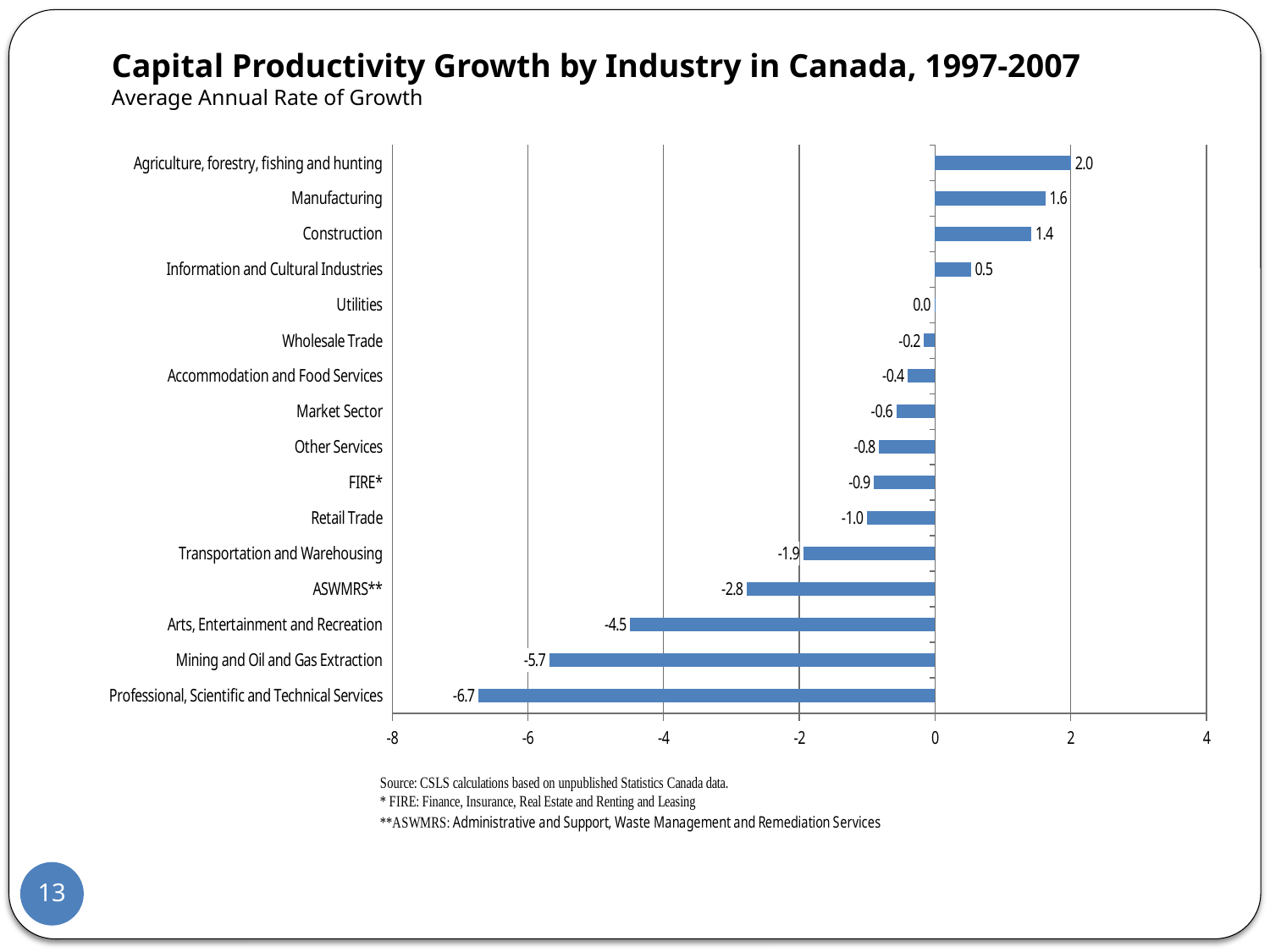
Which industry has the lowest capital productivity growth rate? Professional, Scientific and Technical Services What is the title of the chart? Capital Productivity Growth by Industry in Canada, 1997-2007 What is the value shown for Utilities? 0.0 What is the average annual capital productivity growth rate for Manufacturing? 1.6 What kind of chart is shown on the slide? Bar chart What is the value shown for ASWMRS**? -2.8 What is the difference between the values for Agriculture, forestry, fishing and hunting and Construction? 0.6 Which industry has the highest capital productivity growth rate? Agriculture, forestry, fishing and hunting What is the value shown for Professional, Scientific and Technical Services? -6.7 How many industries are plotted in the chart? 16 Which has a larger value, Mining and Oil and Gas Extraction or Arts, Entertainment and Recreation? Arts, Entertainment and Recreation What is the difference between the values for Transportation and Warehousing and Retail Trade? 0.9